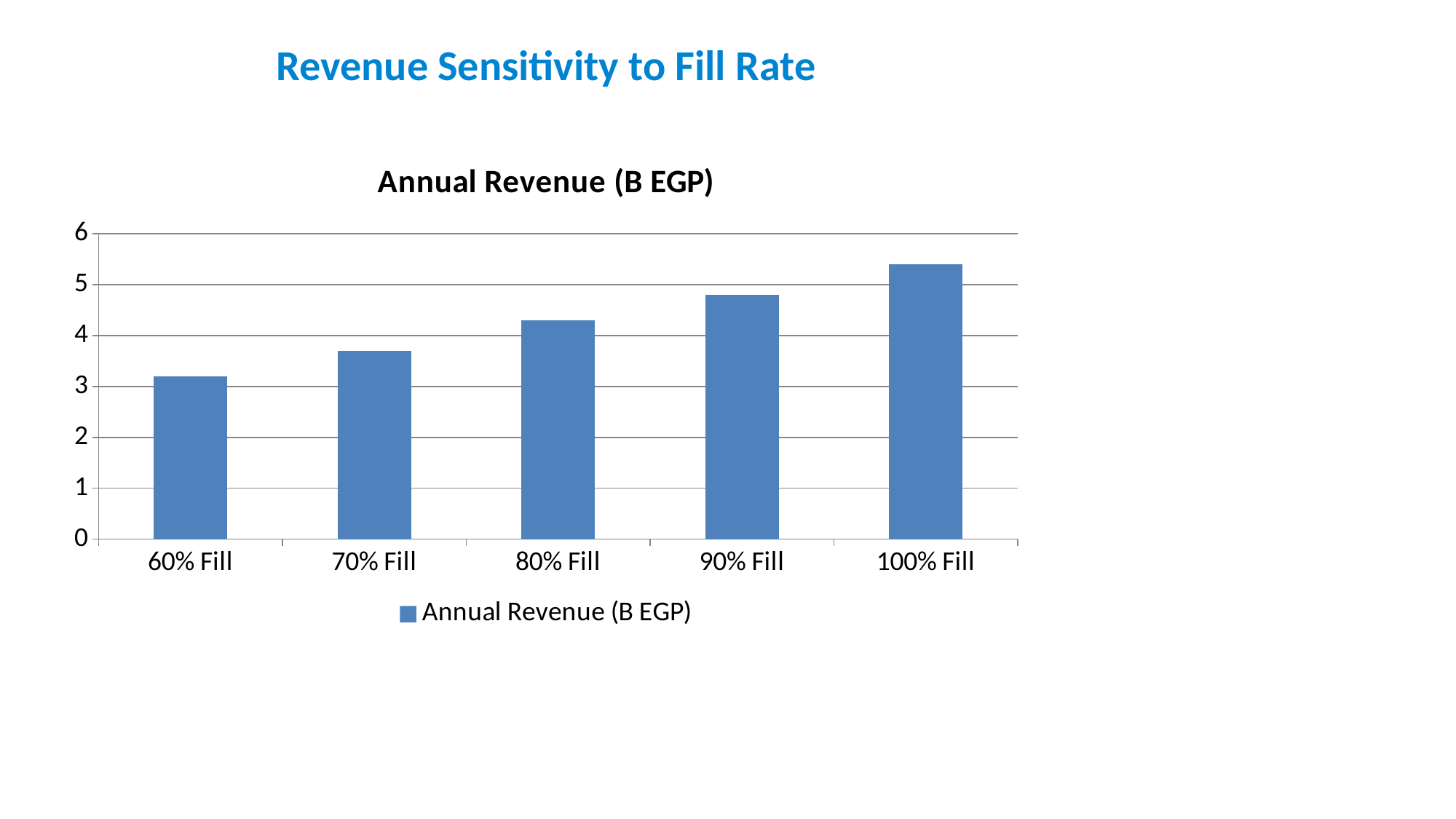
Which fill rate has the highest annual revenue? 100% Fill How many series does the legend list? 1 Which has higher annual revenue, 80% Fill or 70% Fill? 80% Fill Do the annual revenue values rise or fall as the fill rate increases along the x axis? rise Is the annual revenue for 100% Fill greater or less than 5? greater Which fill rate has the lowest annual revenue? 60% Fill Is the annual revenue for 90% Fill greater or less than 5? less What is the title of the chart? Annual Revenue (B EGP) Is the annual revenue for 70% Fill greater or less than 4? less What kind of chart is shown on the slide? bar chart How many fill-rate categories are shown on the x axis? 5